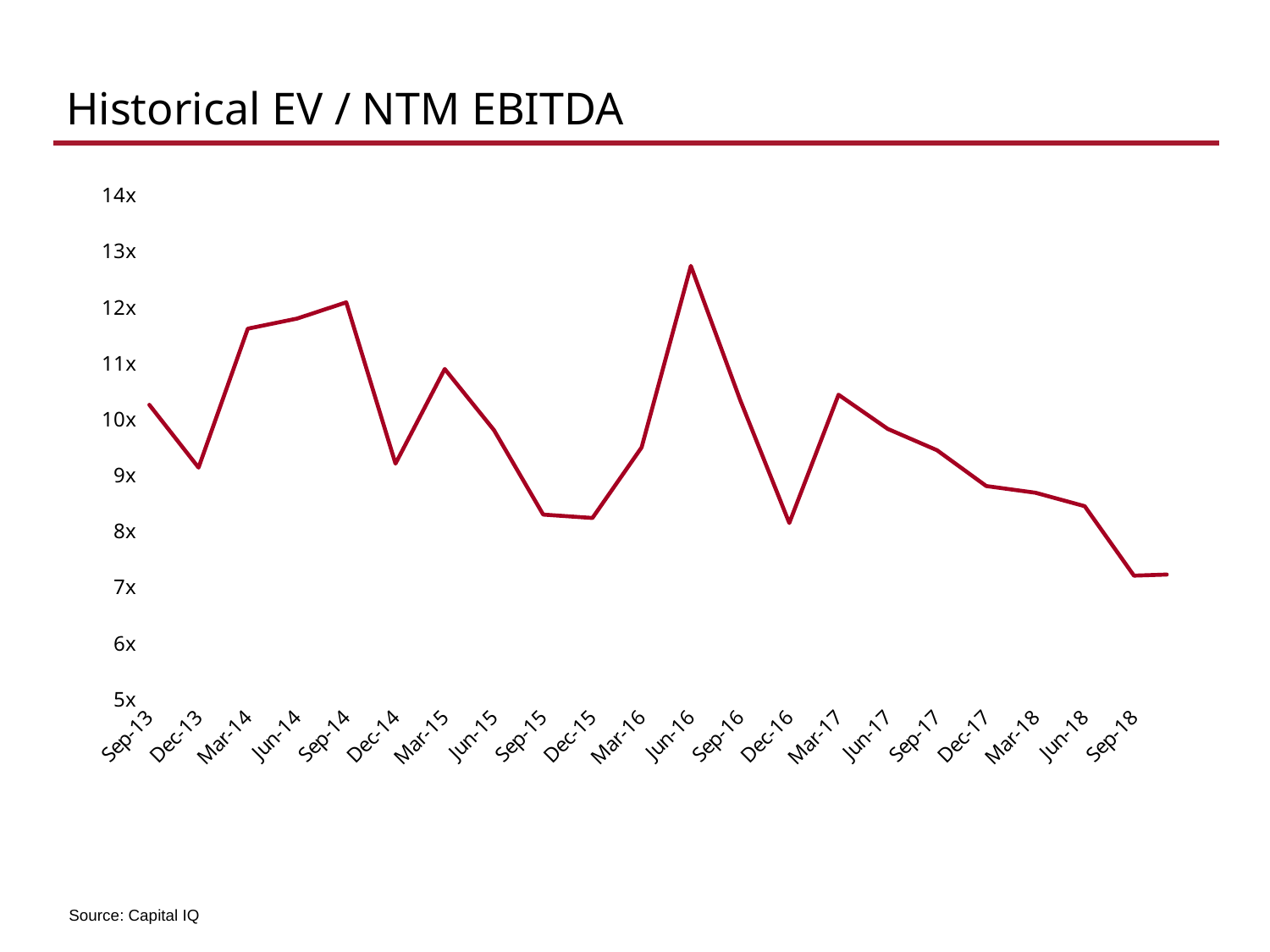
What is the title of the chart? Historical EV / NTM EBITDA Is the value for Mar-14 greater or less than 11x? greater Is the value for Jun-16 greater or less than 12x? greater Overall, does the EV / NTM EBITDA multiple rise or fall from Sep-13 to Sep-18? fall What kind of chart is shown on the slide? line chart What source is cited for the chart? Capital IQ Is the value for Sep-15 greater or less than 9x? less Which quarter has the highest EV / NTM EBITDA multiple? Jun-16 Which is larger, the value for Mar-14 or the value for Dec-14? Mar-14